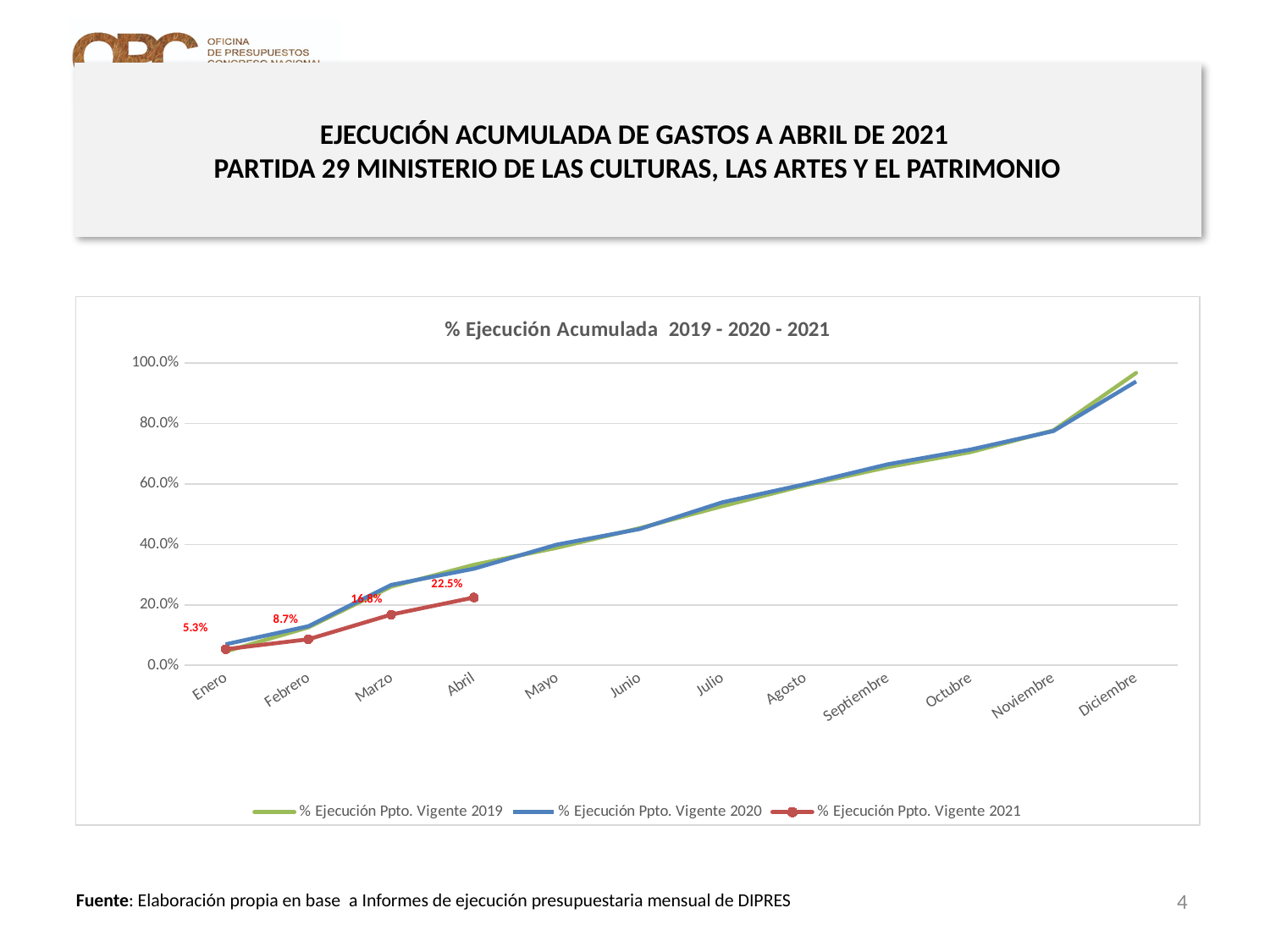
Is the value for % Ejecución Ppto. Vigente 2020 in Diciembre greater or less than 80%? greater Do the values of the % Ejecución Ppto. Vigente 2020 series rise or fall from Enero to Diciembre? rise What is the value of % Ejecución Ppto. Vigente 2021 for Febrero? 8.7% Which is larger in Abril: the 2020 series or the 2021 series? 2020 In which month does the % Ejecución Ppto. Vigente 2021 series reach its highest value? Abril What is the difference between the 2021 values for Febrero and Enero? 3.4% What is the value of % Ejecución Ppto. Vigente 2021 for Enero? 5.3% What is the difference between the 2021 values for Abril and Enero? 17.2% How many months are shown along the x axis of the chart? 12 What is the value of % Ejecución Ppto. Vigente 2021 for Abril? 22.5% What kind of chart is shown on the slide? line chart How many series does the chart legend list? 3